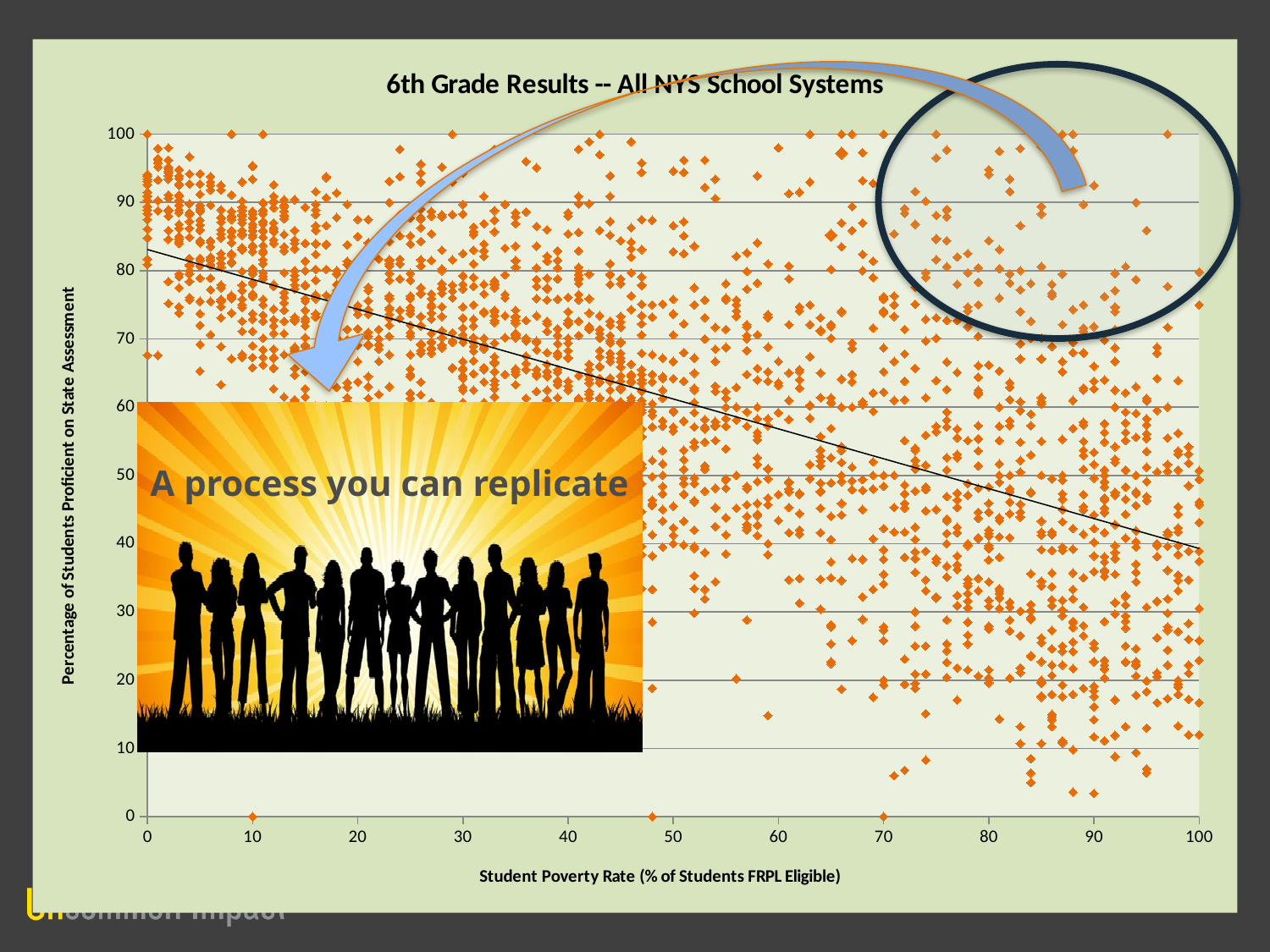
Does the trend line slope upward or downward from left to right? downward What is the highest value shown on the x axis? 100 Do the plotted values generally rise or fall as the student poverty rate increases along the x axis? fall Is the value of the trend line at a poverty rate of 100 greater or less than 50? less What is the title of the chart? 6th Grade Results -- All NYS School Systems Is the value of the trend line at a poverty rate of 0 greater or less than 80? greater What is the label of the x axis? Student Poverty Rate (% of Students FRPL Eligible) What kind of chart is shown on the slide? scatter chart